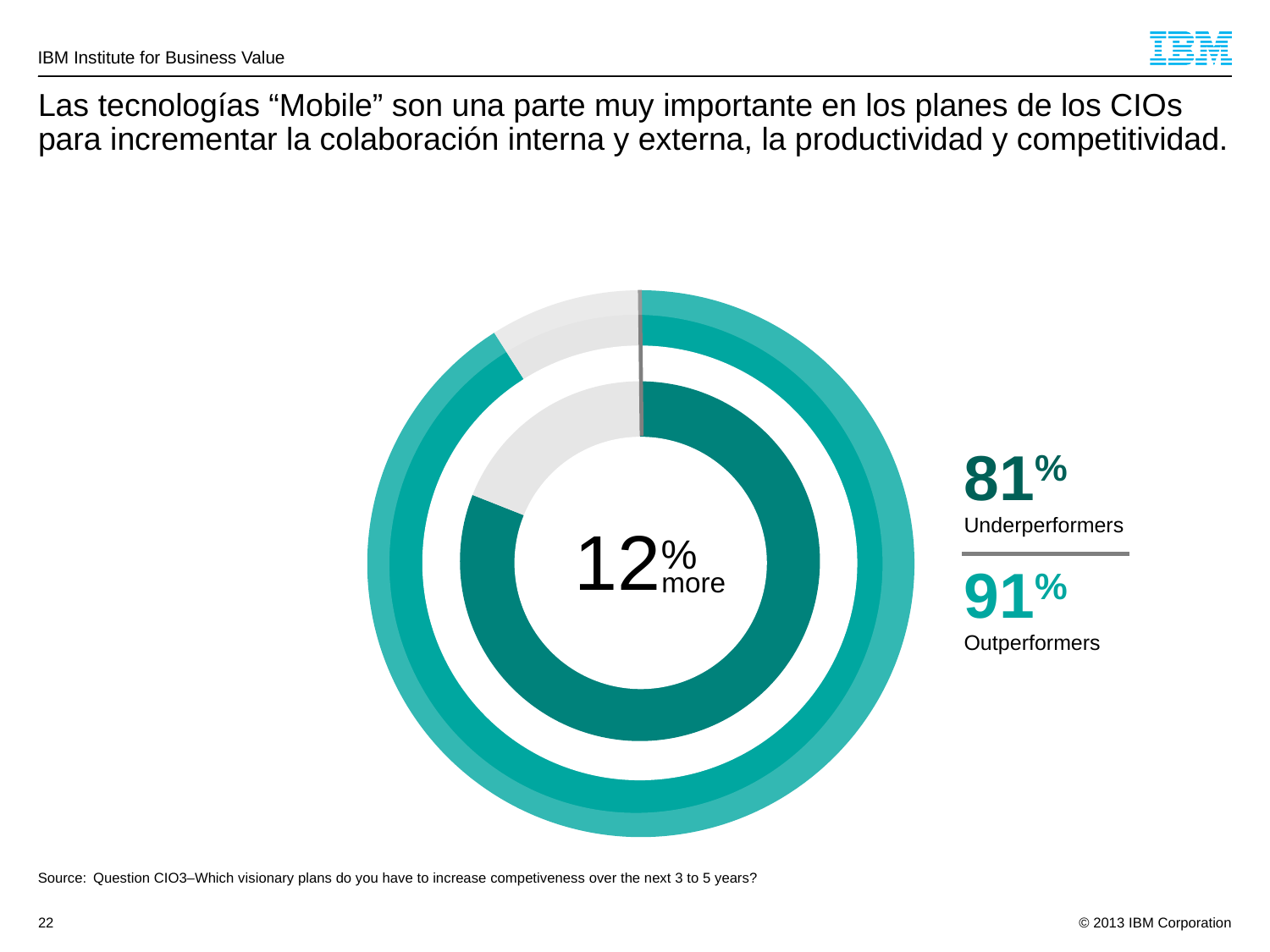
What percentage is shown for Outperformers? 91% What kind of chart is shown on the slide? Donut chart Which group has the highest percentage shown on the chart? Outperformers What percentage is shown for Underperformers? 81% Which group has the higher percentage, Outperformers or Underperformers? Outperformers What text is printed in the centre of the donut chart? 12% more Which group has the lowest percentage shown on the chart? Underperformers Is the value for Outperformers greater or less than 90%? greater By how many percentage points does the Outperformers value exceed the Underperformers value? 10 How many groups are labelled on the chart? 2 Which group does the outer ring of the donut chart represent? Outperformers Is the value for Underperformers greater or less than 90%? less